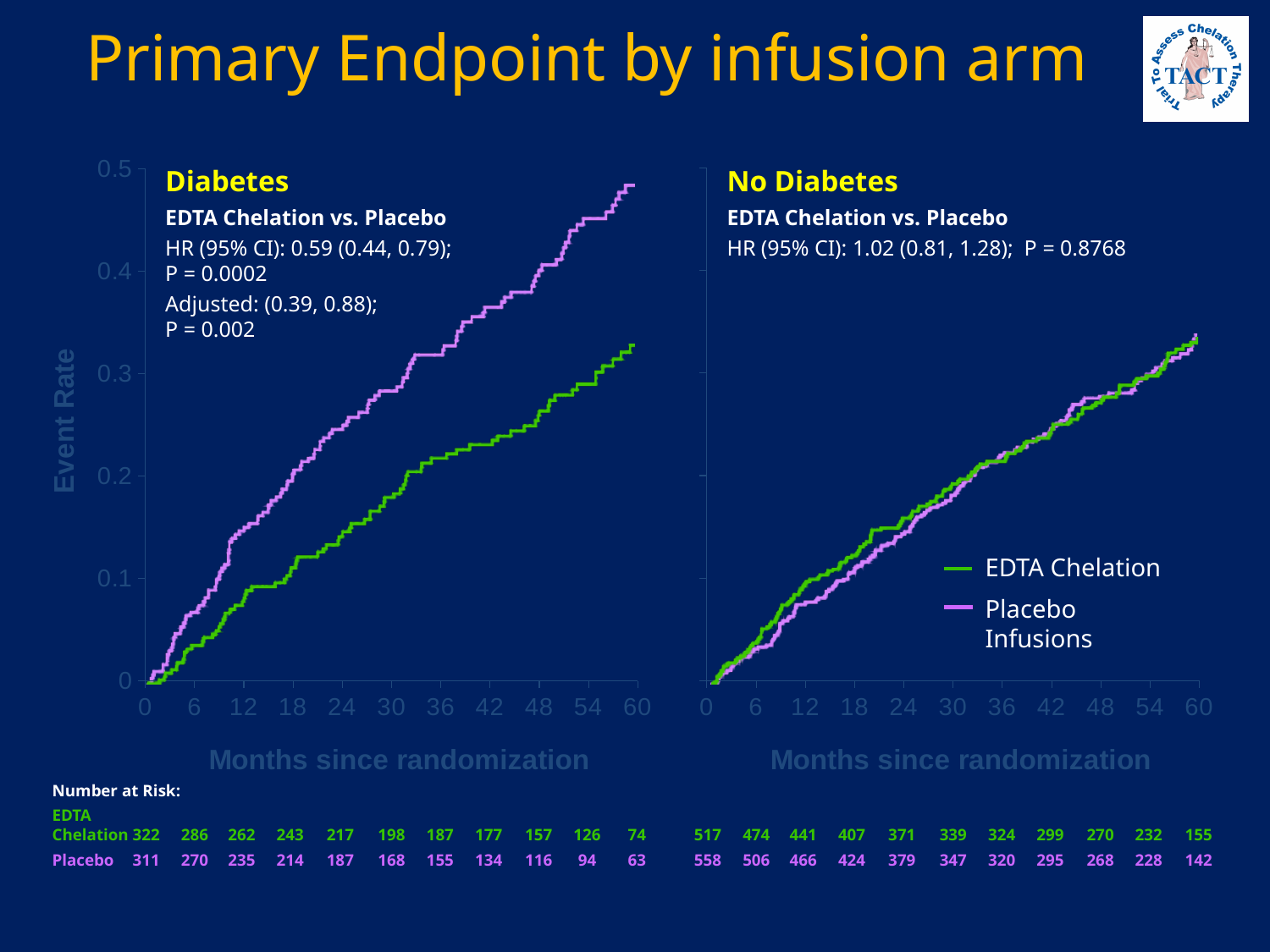
How many series does the legend list for the No Diabetes chart? 2 In the Diabetes chart, is the event rate for EDTA Chelation at 60 months greater or less than 0.4? less In the Diabetes chart, which series has the higher event rate at 60 months, EDTA Chelation or Placebo Infusions? Placebo Infusions What kind of chart is the Diabetes chart on the left? Line chart In the Diabetes chart's Number at Risk table, how many EDTA Chelation patients were at risk at 0 months? 322 In the Diabetes chart, does the event rate for Placebo Infusions rise or fall as months since randomization increase? Rise In the No Diabetes chart, is the event rate for EDTA Chelation at 60 months greater or less than 0.3? greater In the Diabetes chart's Number at Risk table, how many Placebo patients were at risk at 60 months? 63 What hazard ratio (95% CI) is printed on the No Diabetes chart? 1.02 (0.81, 1.28) In the Diabetes chart, is the event rate for Placebo Infusions at 60 months greater or less than 0.4? greater In the No Diabetes chart's Number at Risk table, how many Placebo patients were at risk at 0 months? 558 In the No Diabetes chart's Number at Risk table, what is the difference between the Placebo and EDTA Chelation numbers at risk at 0 months? 41